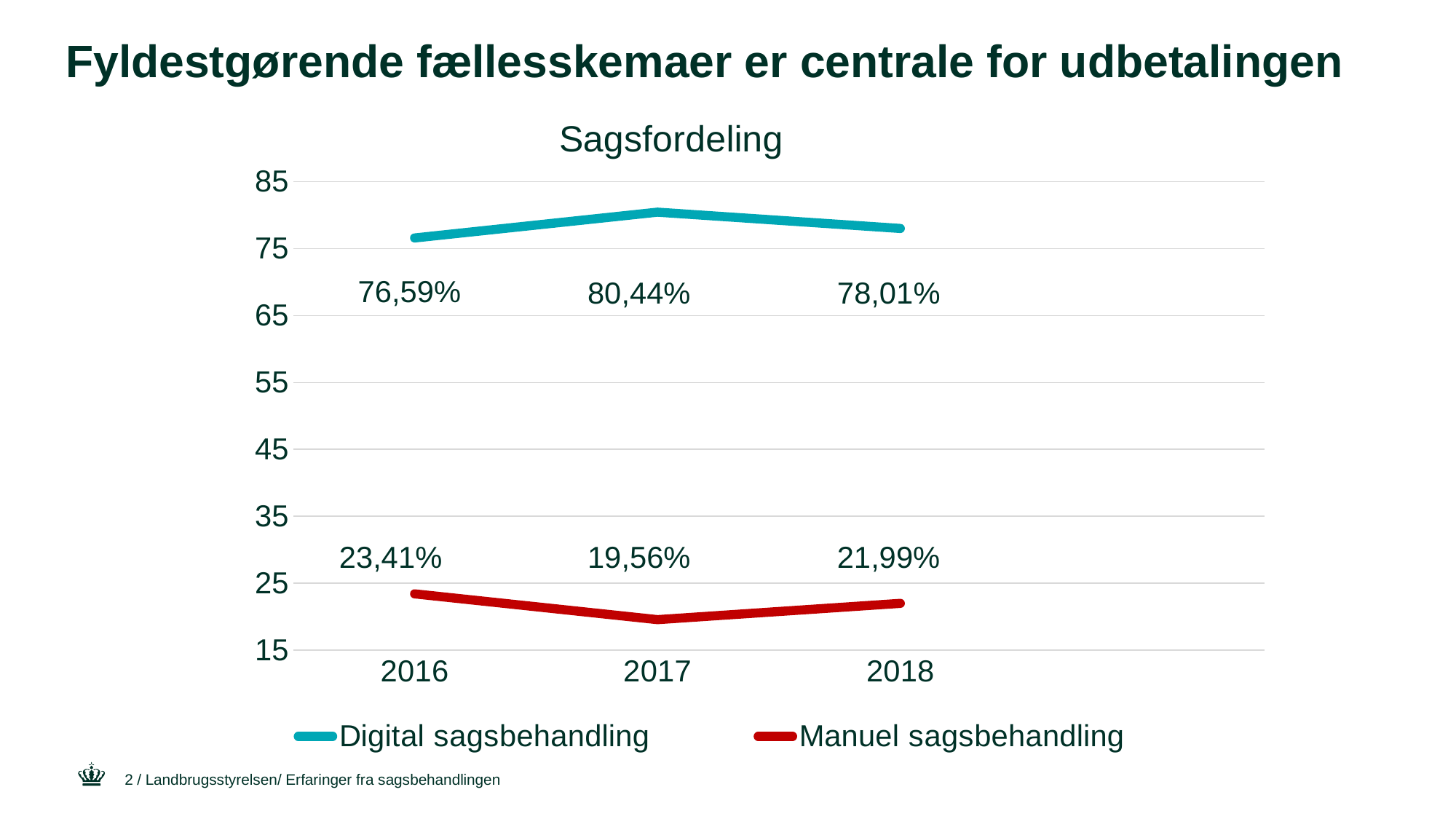
What is the difference between Digital sagsbehandling in 2017 and in 2016? 3,85% What is the title of the chart? Sagsfordeling How many years are shown on the x axis? 3 How many series does the legend list? 2 Which is larger for Manuel sagsbehandling: the value in 2016 or in 2018? 2016 What is the value for Manuel sagsbehandling in 2016? 23,41% Is the value for Digital sagsbehandling in 2016 greater or less than 75? greater What kind of chart is shown? Line chart What is the value for Digital sagsbehandling in 2017? 80,44% What is the value for Digital sagsbehandling in 2018? 78,01% In which year is Manuel sagsbehandling lowest? 2017 In which year is Digital sagsbehandling highest? 2017